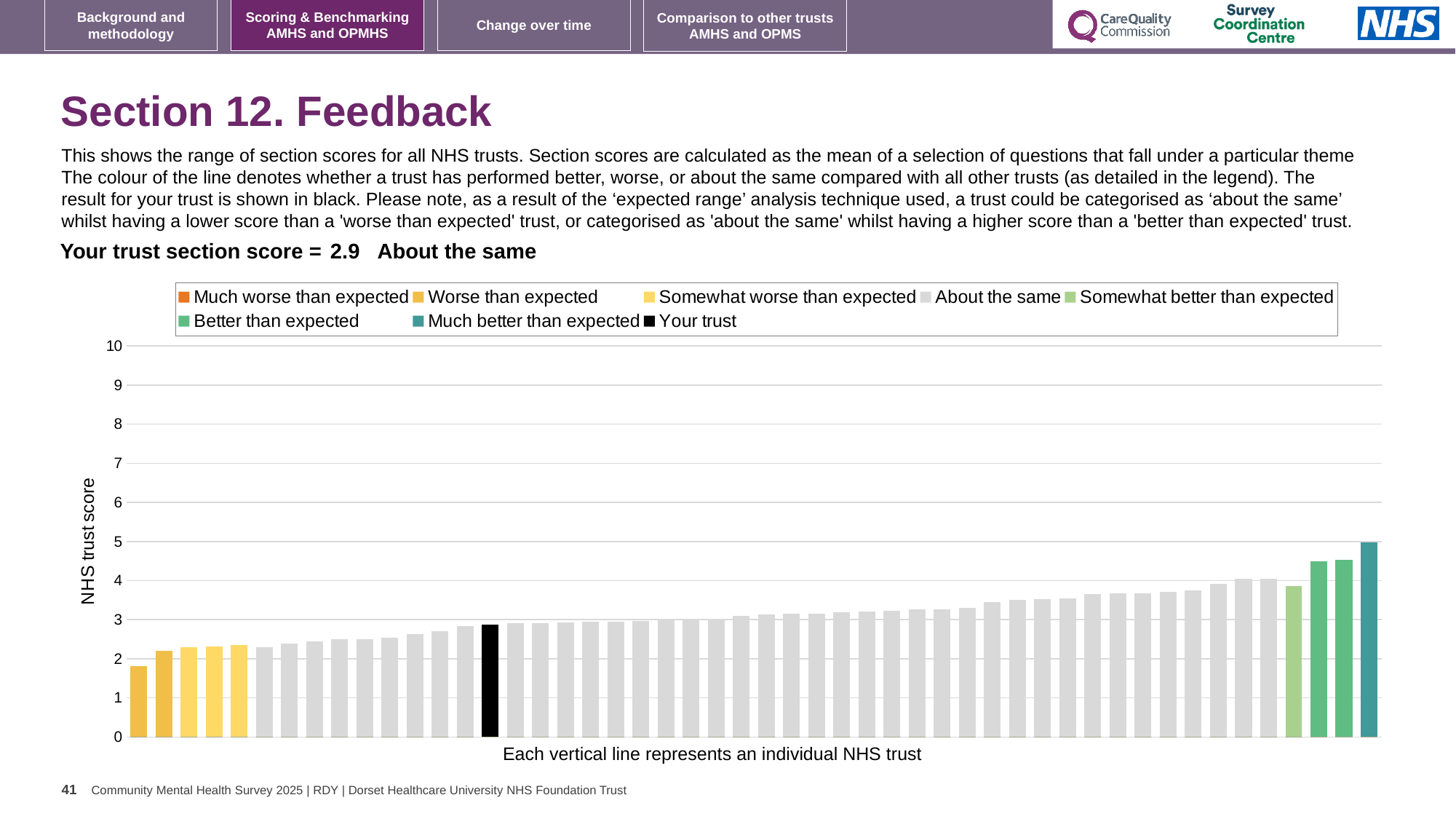
What is the section score for your trust shown on the slide? 2.9 Which category is your trust placed in for this section? About the same Which legend category does the highest-scoring trust belong to? Much better than expected How many bars are coloured as 'Better than expected'? 2 Is the value of the tallest bar greater or less than 4? greater Do the bar values rise or fall from left to right along the x axis? rise What kind of chart is shown on the slide? bar chart Is the value of the shortest bar greater or less than 2? less Is the value of the tallest bar greater or less than 6? less What colour is the bar representing your trust? black What is the label on the vertical axis of the chart? NHS trust score How many entries does the chart legend list? 8